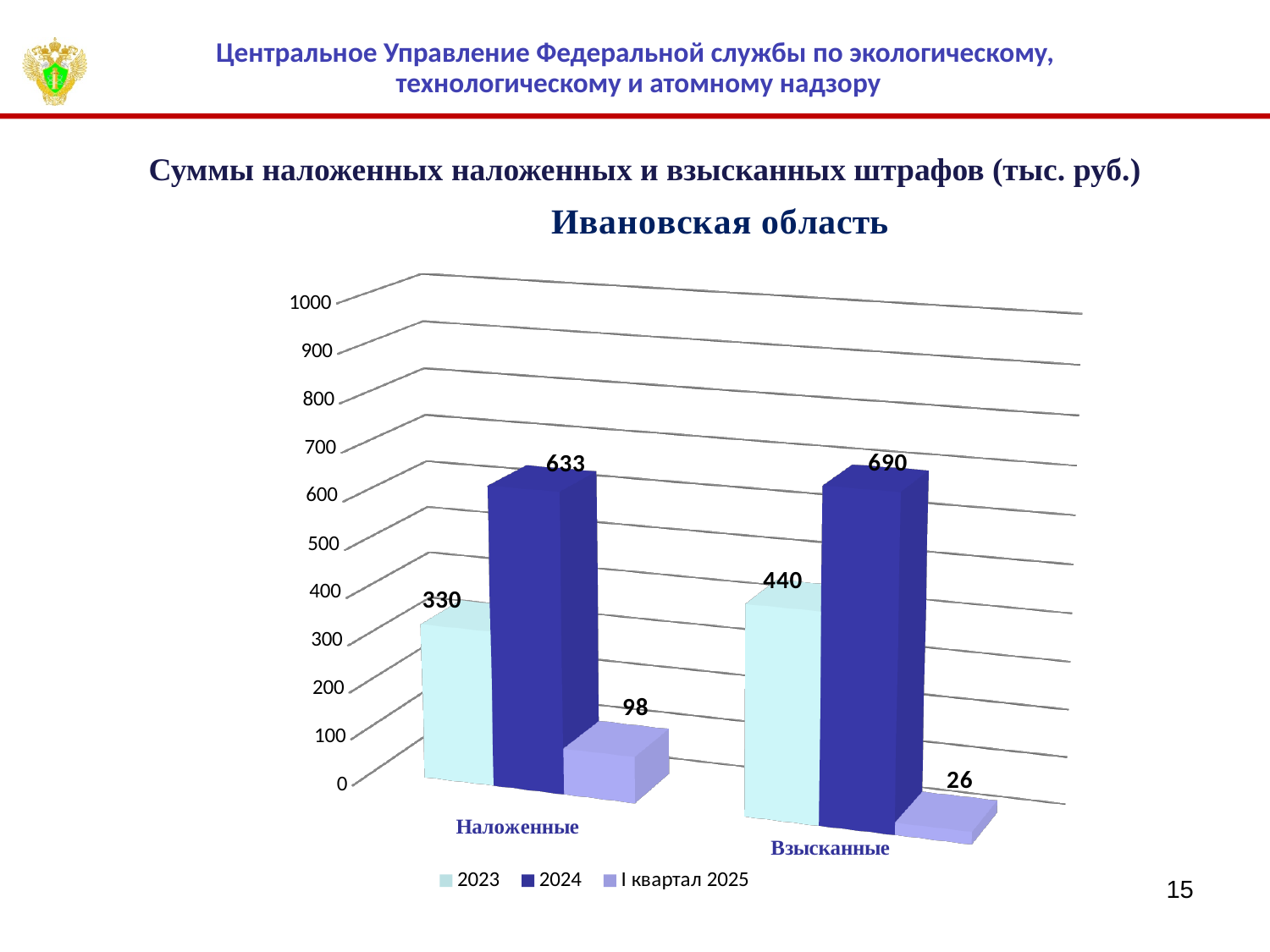
How many series does the legend list? 3 Which region is named in the chart title? Ивановская область Which is larger: the 2023 value for Наложенные or the 2023 value for Взысканные? Взысканные Which series has the lowest value in the Наложенные category? I квартал 2025 What is the difference between the 2023 and I квартал 2025 values in the Наложенные category? 232 What is the value for I квартал 2025 in the Наложенные category? 98 What is the difference between the 2024 values for Взысканные and Наложенные? 57 What is the value for I квартал 2025 in the Взысканные category? 26 What kind of chart is shown on the slide? bar chart Which series has the highest value in the Взысканные category? 2024 What is the value for 2023 in the Взысканные category? 440 What is the value for 2024 in the Наложенные category? 633